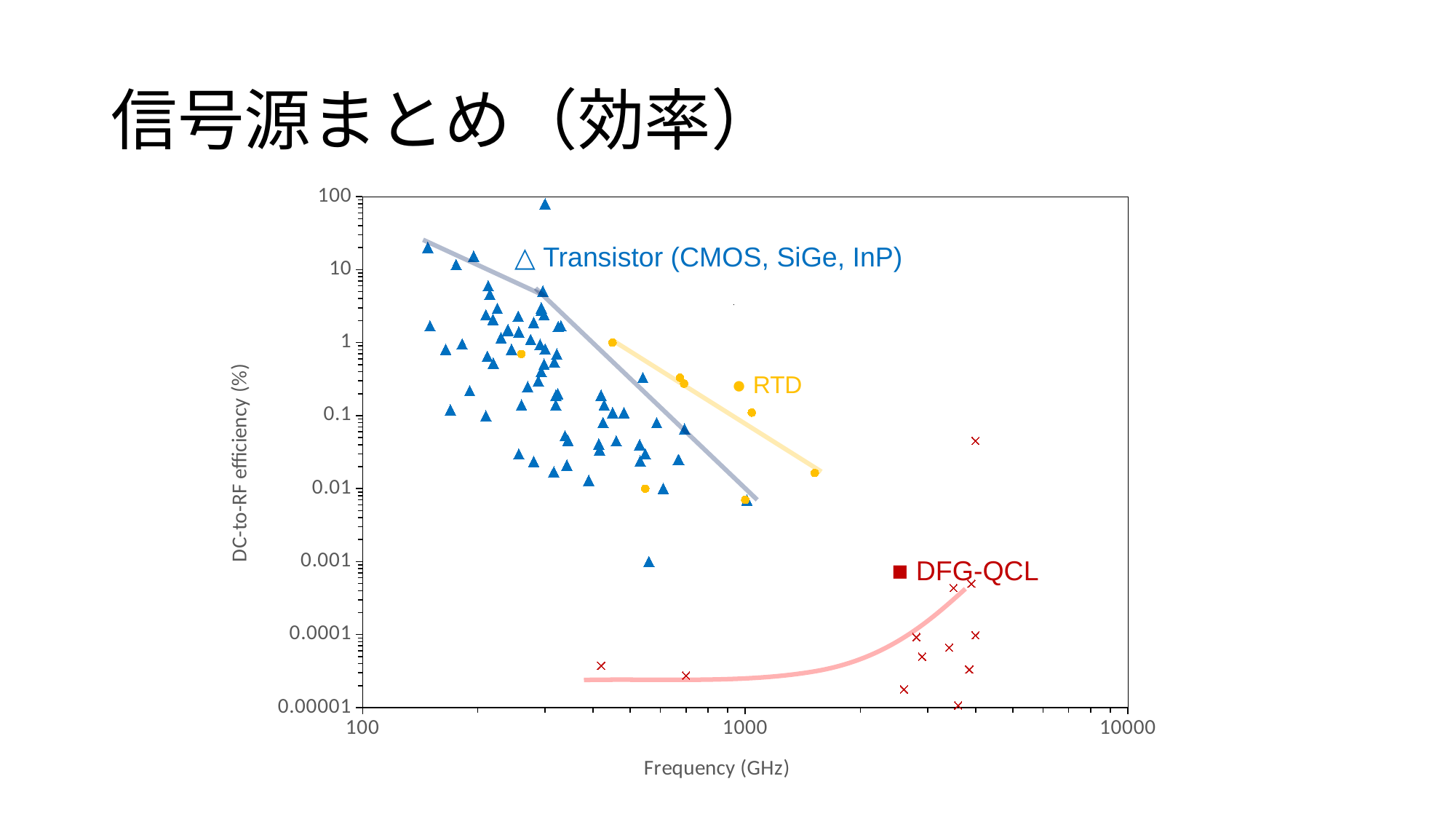
What is the highest value shown on the vertical axis? 100 Which series has the lowest DC-to-RF efficiency values overall? DFG-QCL Along the fitted trend line, does the DFG-QCL efficiency rise or fall as frequency increases from 1000 GHz to 4000 GHz? rise As frequency increases, does the DC-to-RF efficiency of the Transistor series generally rise or fall? fall Is the highest Transistor data point greater or less than 10% efficiency? greater Is the lowest DFG-QCL data point greater or less than 0.0001% efficiency? less How many data series are labelled on the chart? 3 What is the label of the vertical axis of the chart? DC-to-RF efficiency (%) Is the RTD data point at the highest frequency (around 1500 GHz) greater or less than 0.1% efficiency? less Which series is plotted with red cross markers? DFG-QCL Which series reaches the highest DC-to-RF efficiency on the chart? Transistor (CMOS, SiGe, InP) What kind of chart is shown on the slide? scatter chart